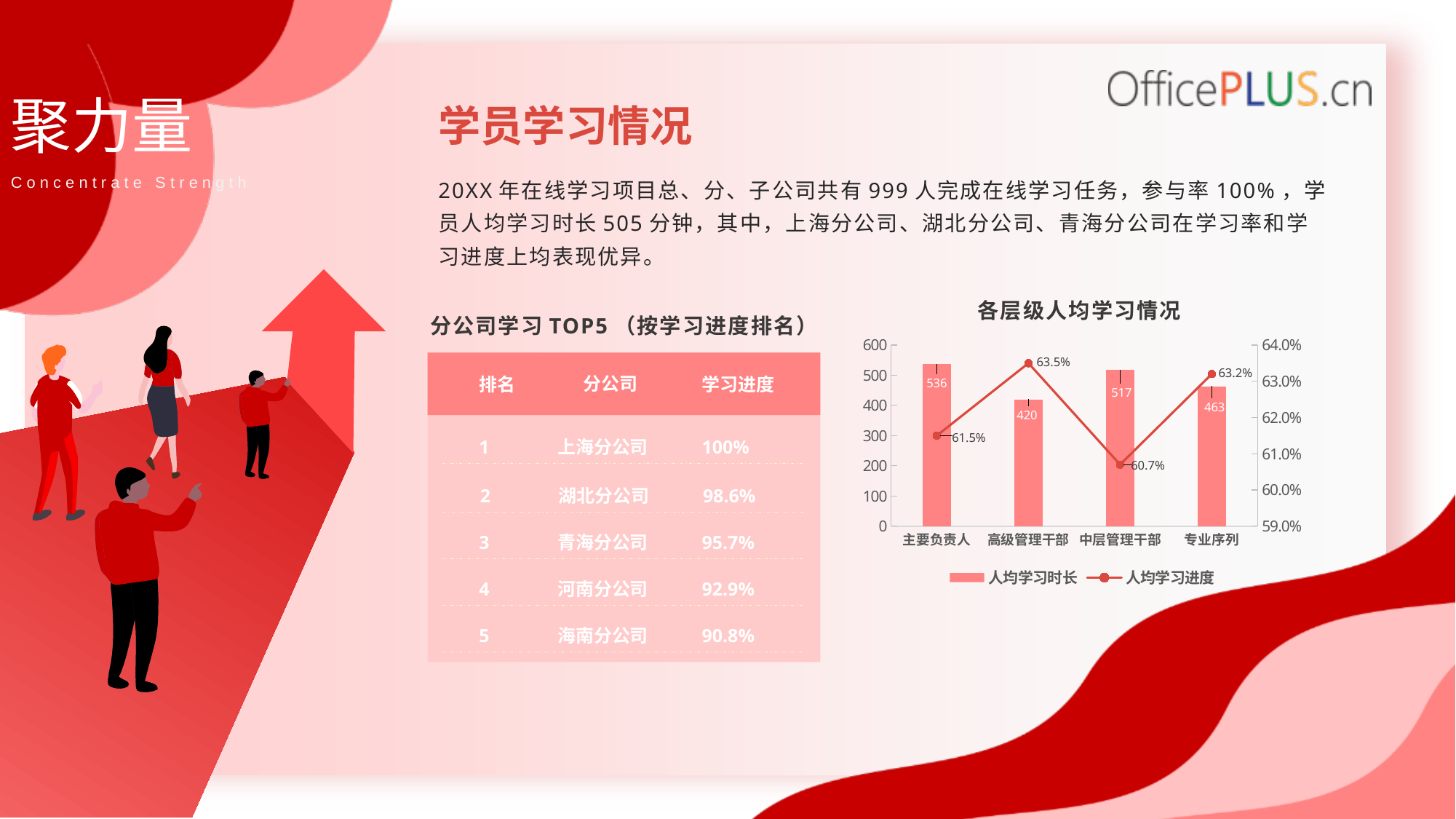
Which has a higher 人均学习时长, 中层管理干部 or 专业序列? 中层管理干部 Which category has the lowest 人均学习进度? 中层管理干部 What is the 人均学习时长 value for 主要负责人? 536 How many series does the chart legend list? 2 What is the difference in 人均学习时长 between 主要负责人 and 高级管理干部? 116 What is the title of the chart? 各层级人均学习情况 Is the 人均学习时长 value for 高级管理干部 greater or less than 500? less What is the 人均学习时长 value for 专业序列? 463 What is the 人均学习进度 value for 高级管理干部? 63.5% Which category has the highest 人均学习时长? 主要负责人 How many categories are shown on the x axis of the chart? 4 What is the 人均学习进度 value for 中层管理干部? 60.7%